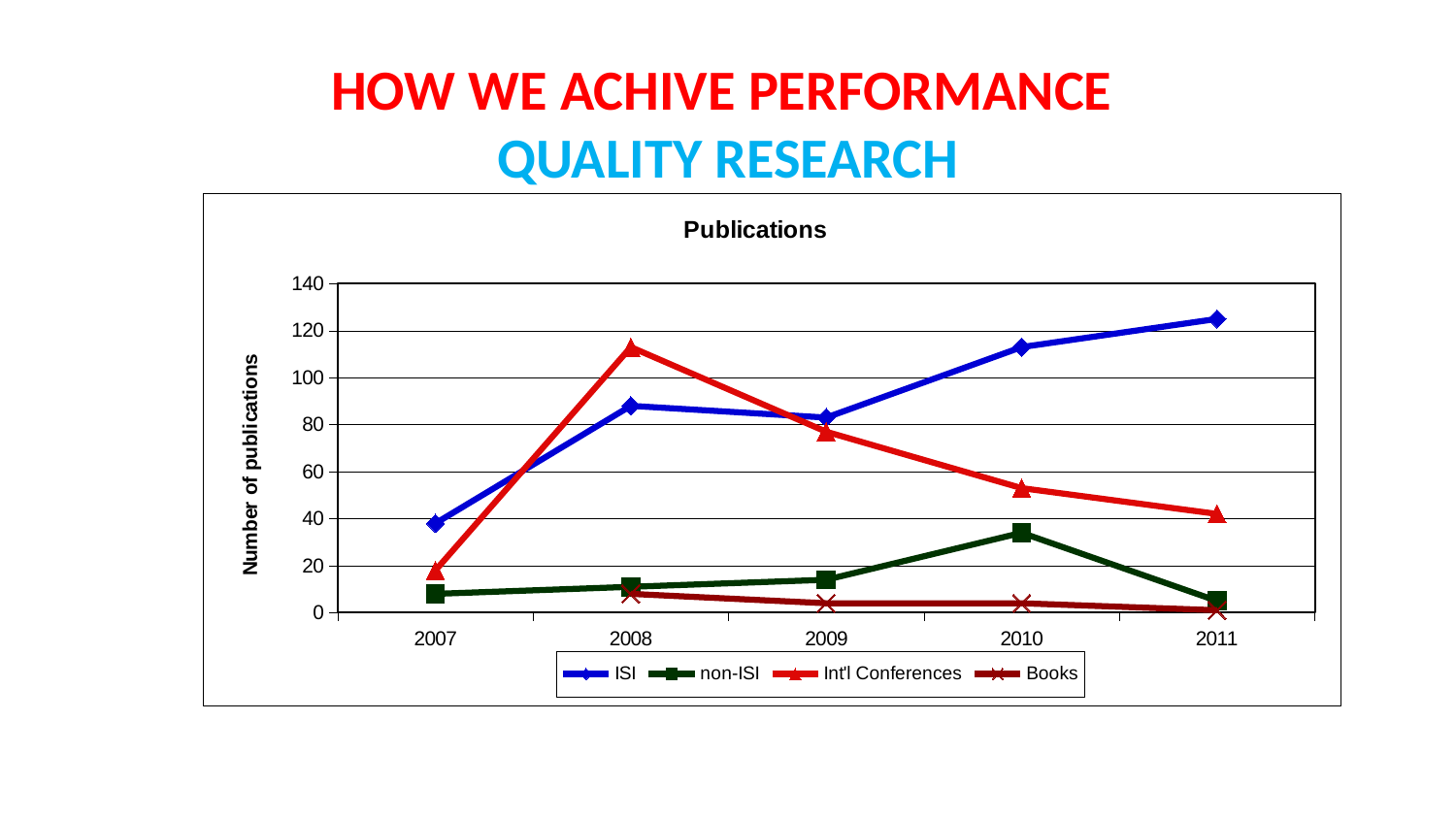
Does the Int'l Conferences series rise or fall from 2008 to 2011? fall In which year is the Int'l Conferences series at its highest? 2008 In which year is the non-ISI series at its highest? 2010 In which year is the ISI series at its highest? 2011 In 2010, which is larger: ISI or Int'l Conferences? ISI What is the label on the vertical axis of the chart? Number of publications How many series does the legend of the Publications chart list? 4 How many years are shown on the x axis of the Publications chart? 5 Is the value for ISI in 2011 greater or less than 120? greater In 2008, which is larger: ISI or Int'l Conferences? Int'l Conferences What is the title of the chart? Publications What kind of chart is shown on the slide? Line chart